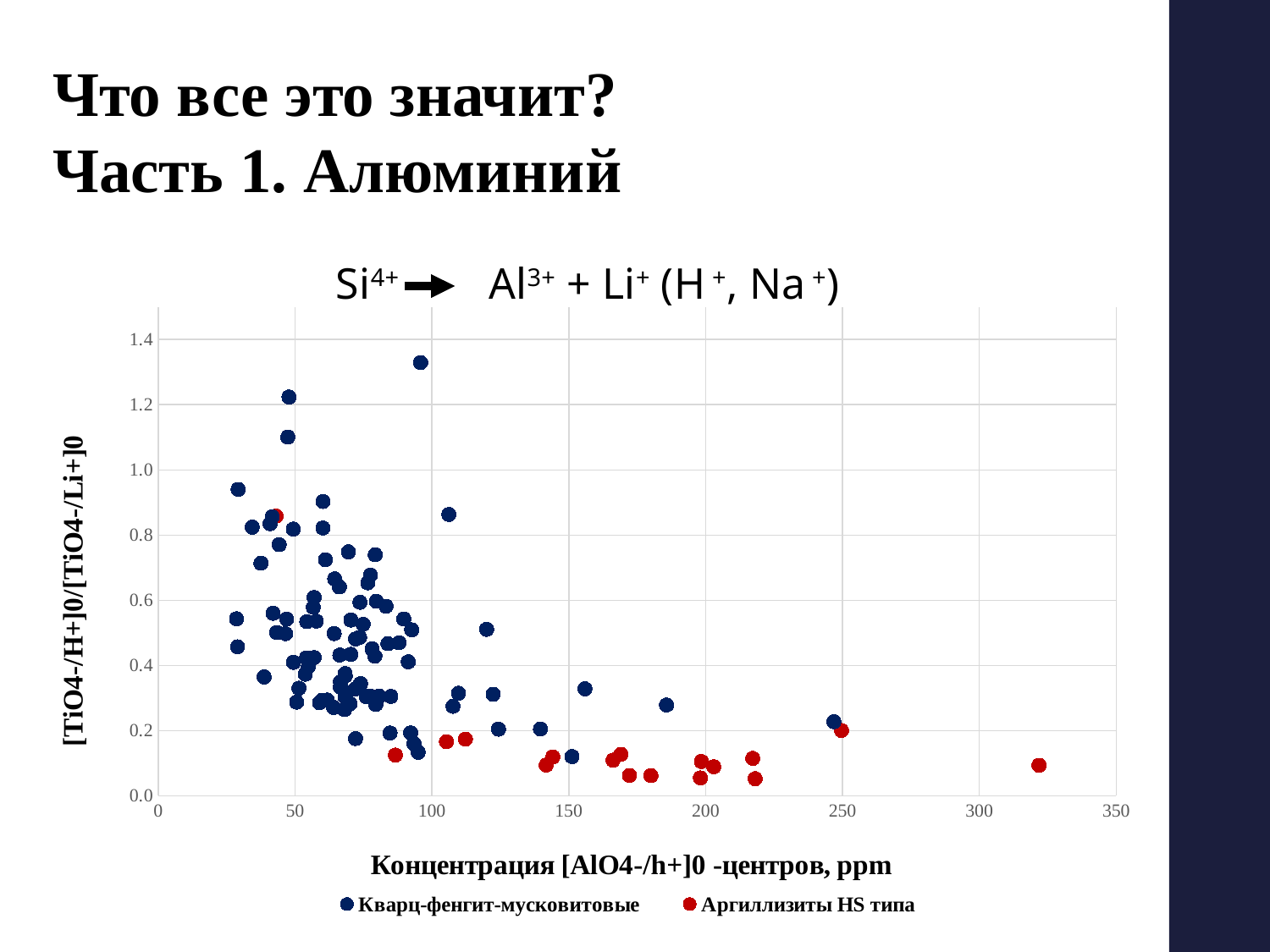
Which series does the rightmost point on the chart belong to? Аргиллизиты HS типа What kind of chart is shown on the slide? scatter chart Is the y value of the highest point on the chart greater or less than 1.2? greater Overall, do the y values rise or fall as the x value increases? fall Is the x value of the rightmost point on the chart greater or less than 300? greater Is the y value of the rightmost point on the chart greater or less than 0.2? less Which series reaches the highest y value on the chart? Кварц-фенгит-мусковитовые Which series is plotted in red? Аргиллизиты HS типа What is the title of the x axis? Концентрация [AlO4-/h+]0 -центров, ppm What are the two series named in the legend? Кварц-фенгит-мусковитовые and Аргиллизиты HS типа How many series does the legend list? 2